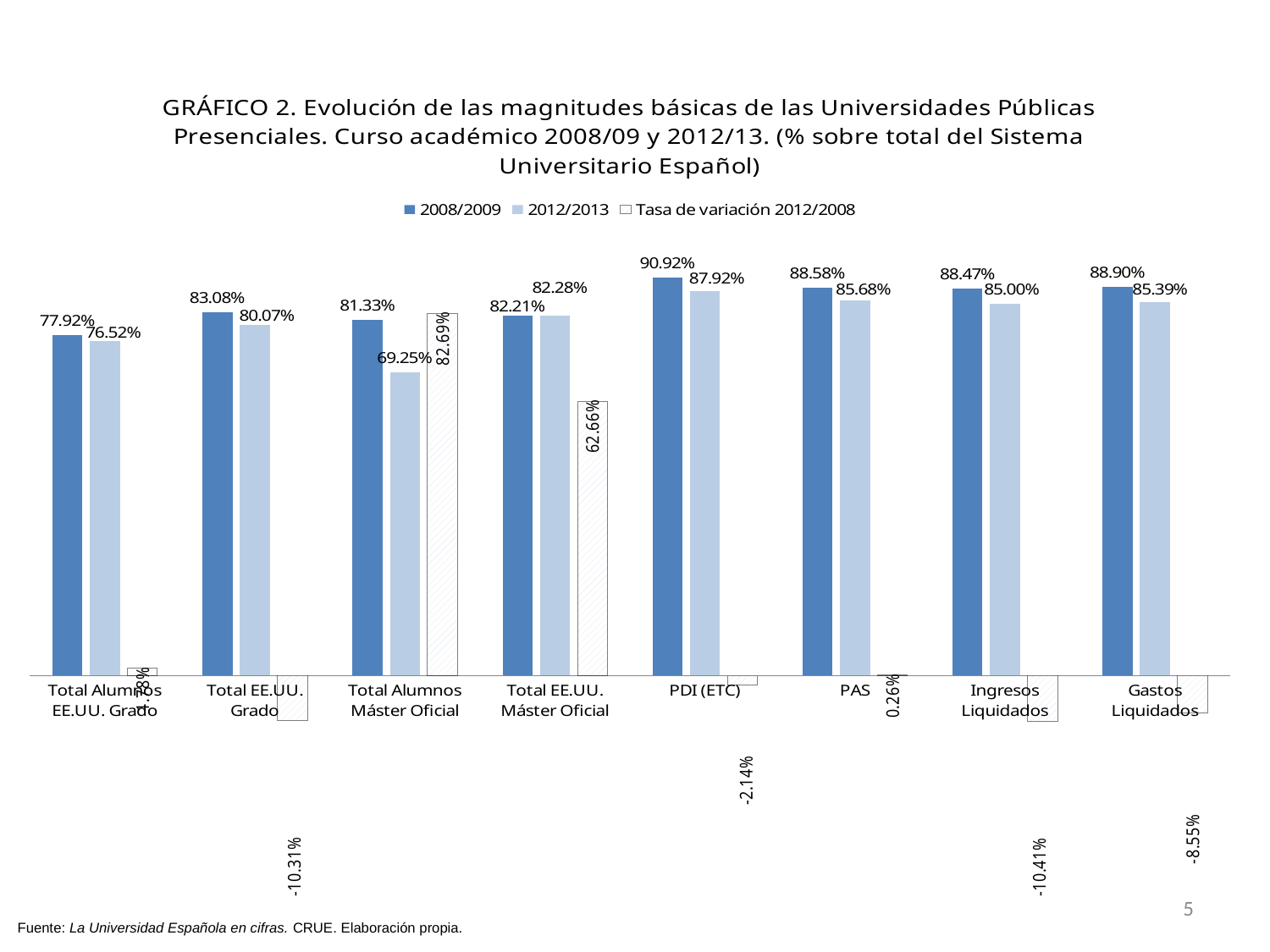
What is the 2008/2009 value for PDI (ETC)? 90.92% Which category has the lowest 2012/2013 value? Total Alumnos Máster Oficial What is the 2012/2013 value for Total Alumnos Máster Oficial? 69.25% What is the difference between the 2008/2009 and 2012/2013 values for Total Alumnos Máster Oficial? 12.08% What is the Tasa de variación 2012/2008 value for Ingresos Liquidados? -10.41% What kind of chart is shown on the slide? Bar chart For Total EE.UU. Máster Oficial, which is larger: the 2008/2009 value or the 2012/2013 value? 2012/2013 What is the difference between the 2008/2009 and 2012/2013 values for PDI (ETC)? 3.00% What is the Tasa de variación 2012/2008 value for PAS? 0.26% Which category has the highest 2008/2009 value? PDI (ETC) How many categories are shown on the x axis? 8 How many series does the legend list? 3